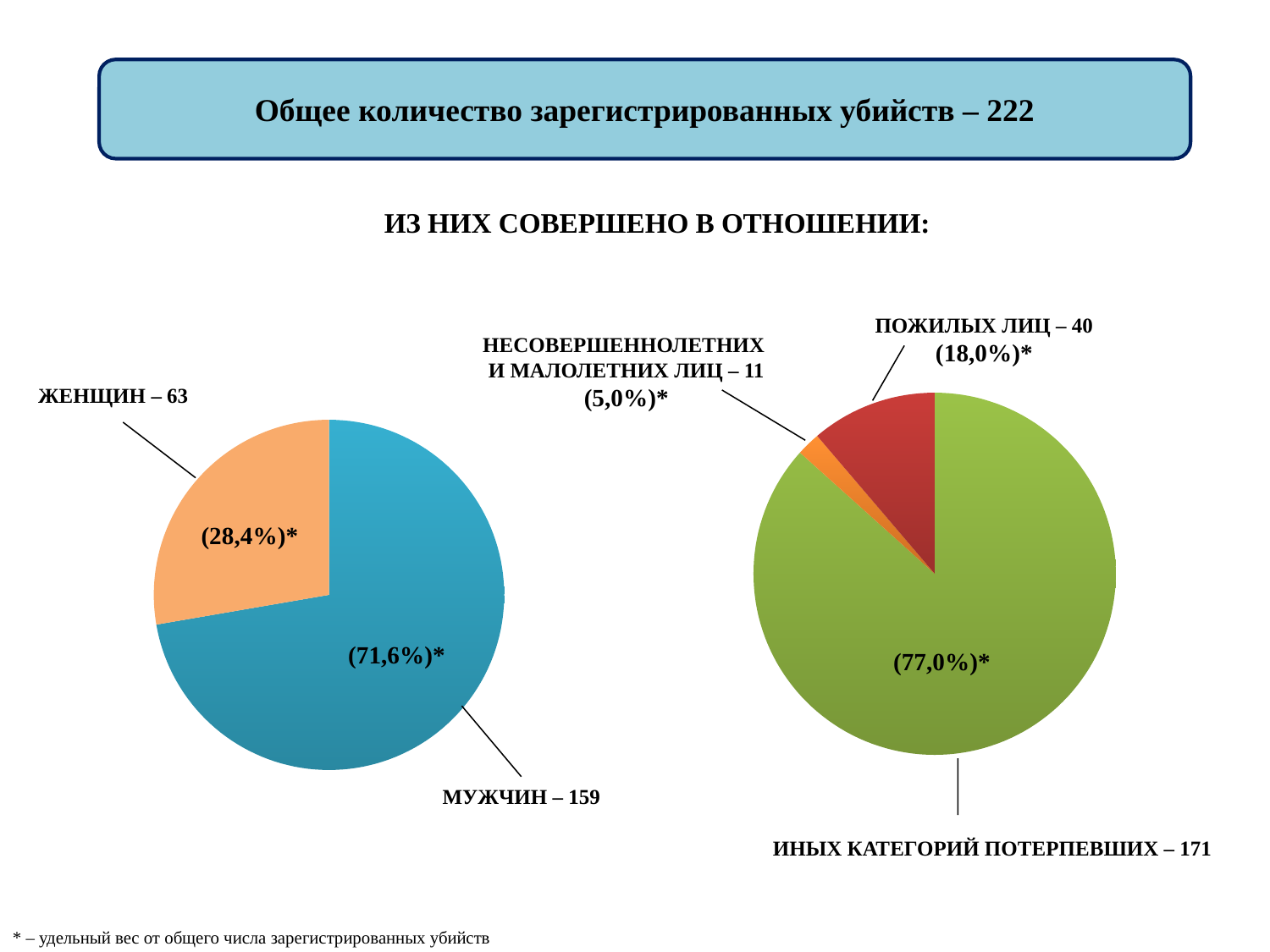
На левой круговой диаграмме на сколько число убийств мужчин больше числа убийств женщин? 96 На левой круговой диаграмме какова доля убийств в отношении мужчин? 71,6% Какого типа диаграммы показаны на слайде? Круговые диаграммы На правой круговой диаграмме какова доля иных категорий потерпевших? 77,0% На правой круговой диаграмме что больше: число убийств пожилых лиц или несовершеннолетних и малолетних лиц? Пожилых лиц На левой круговой диаграмме сколько убийств совершено в отношении мужчин? 159 На левой круговой диаграмме какова доля убийств в отношении женщин? 28,4% На правой круговой диаграмме сколько убийств совершено в отношении пожилых лиц? 40 На правой круговой диаграмме какая категория имеет наименьшее число убийств? Несовершеннолетних и малолетних лиц На правой круговой диаграмме сколько категорий потерпевших показано? 3 На левой круговой диаграмме сколько убийств совершено в отношении женщин? 63 На правой круговой диаграмме сколько убийств совершено в отношении несовершеннолетних и малолетних лиц? 11